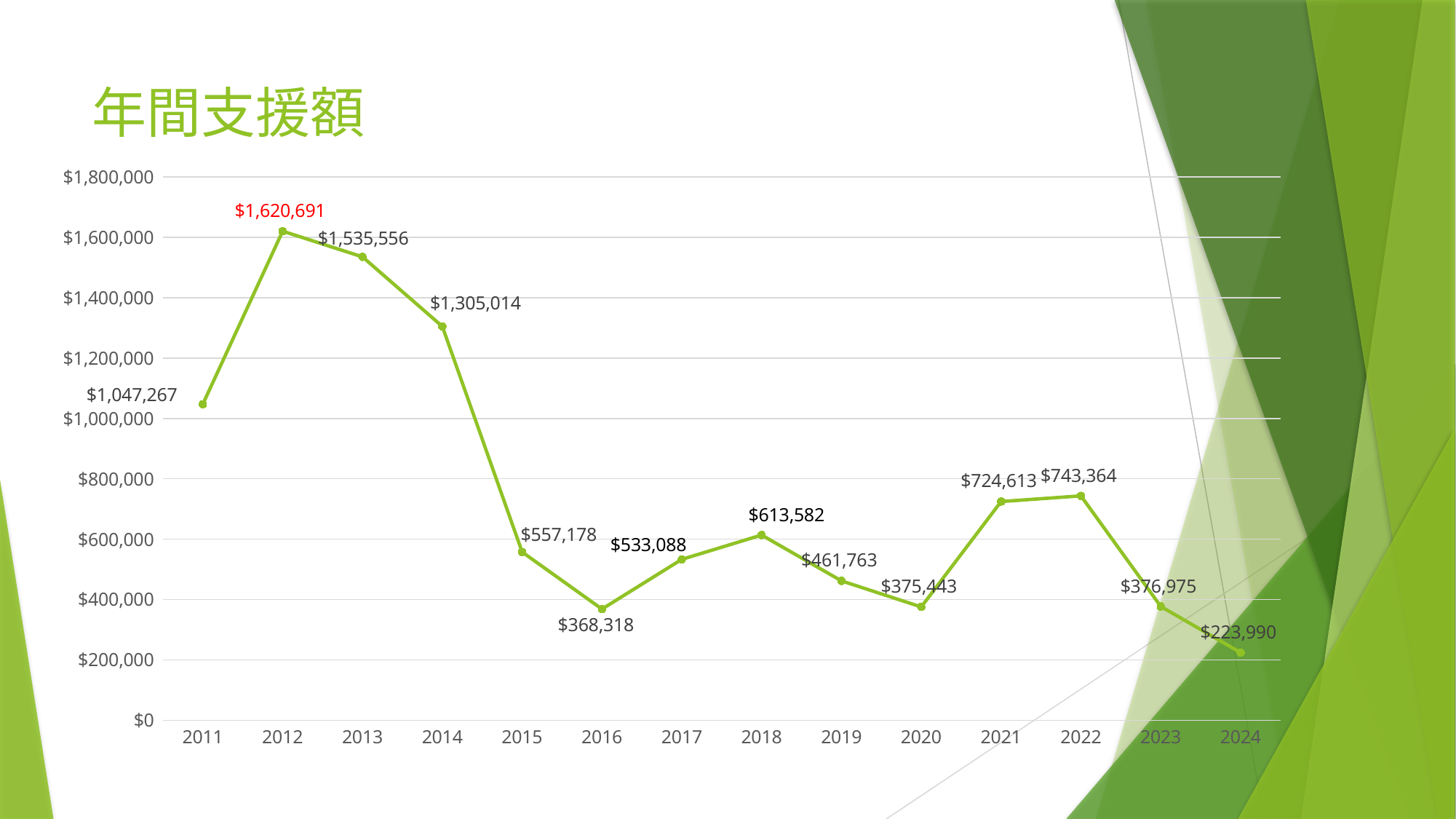
Does the value fall or rise from 2022 to 2024? fall What is the title of the chart? 年間支援額 What is the value for 2012? $1,620,691 What is the value for 2024? $223,990 What is the value for 2016? $368,318 How many years are plotted on the chart? 14 What is the difference between the values for 2022 and 2021? $18,751 Which year has the highest value? 2012 Which year has the lowest value? 2024 Which is larger, the value for 2018 or the value for 2019? 2018 What type of chart is shown on the slide? line chart What is the difference between the values for 2012 and 2011? $573,424